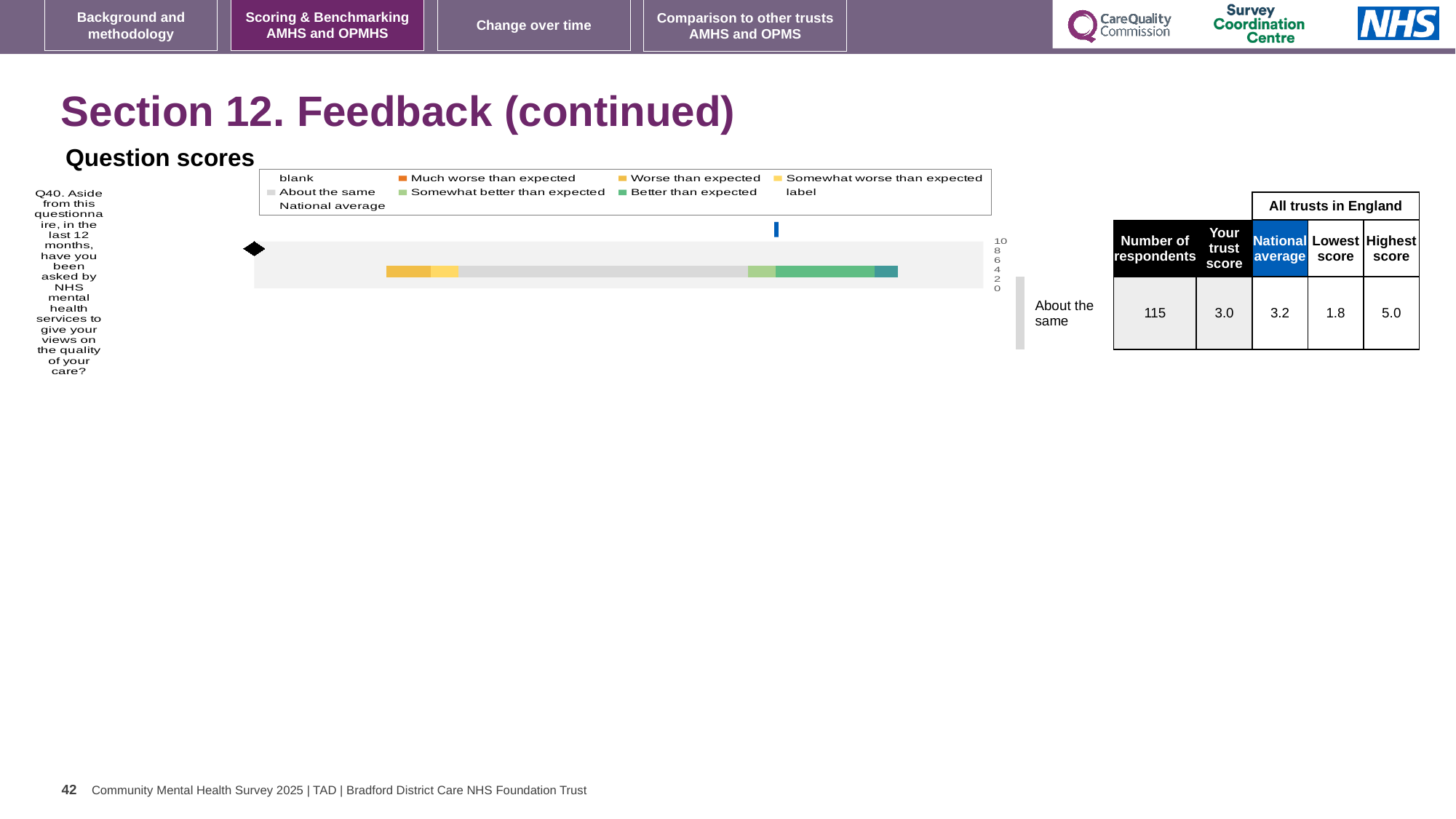
How many questions (categories) are plotted in the Question scores chart? 1 In the table next to the chart, what is the highest score among all trusts in England for Q40? 5.0 What benchmark label is shown to the right of the Q40 bar? About the same What kind of chart is shown under 'Question scores'? Bar chart In the table next to the chart, which is larger for Q40: the trust score or the national average? National average In the table next to the chart, what is the lowest score among all trusts in England for Q40? 1.8 Which legend entry in the Question scores chart is shown in orange? Much worse than expected In the table next to the chart, what is the trust's score for Q40? 3.0 Which question is plotted in the Question scores chart? Q40. Aside from this questionnaire, in the last 12 months, have you been asked by NHS mental health services to give your views on the quality of your care? What is the highest tick value shown on the axis of the Question scores chart? 10 In the table next to the chart, what is the number of respondents for Q40? 115 In the table next to the chart, what is the national average for Q40? 3.2